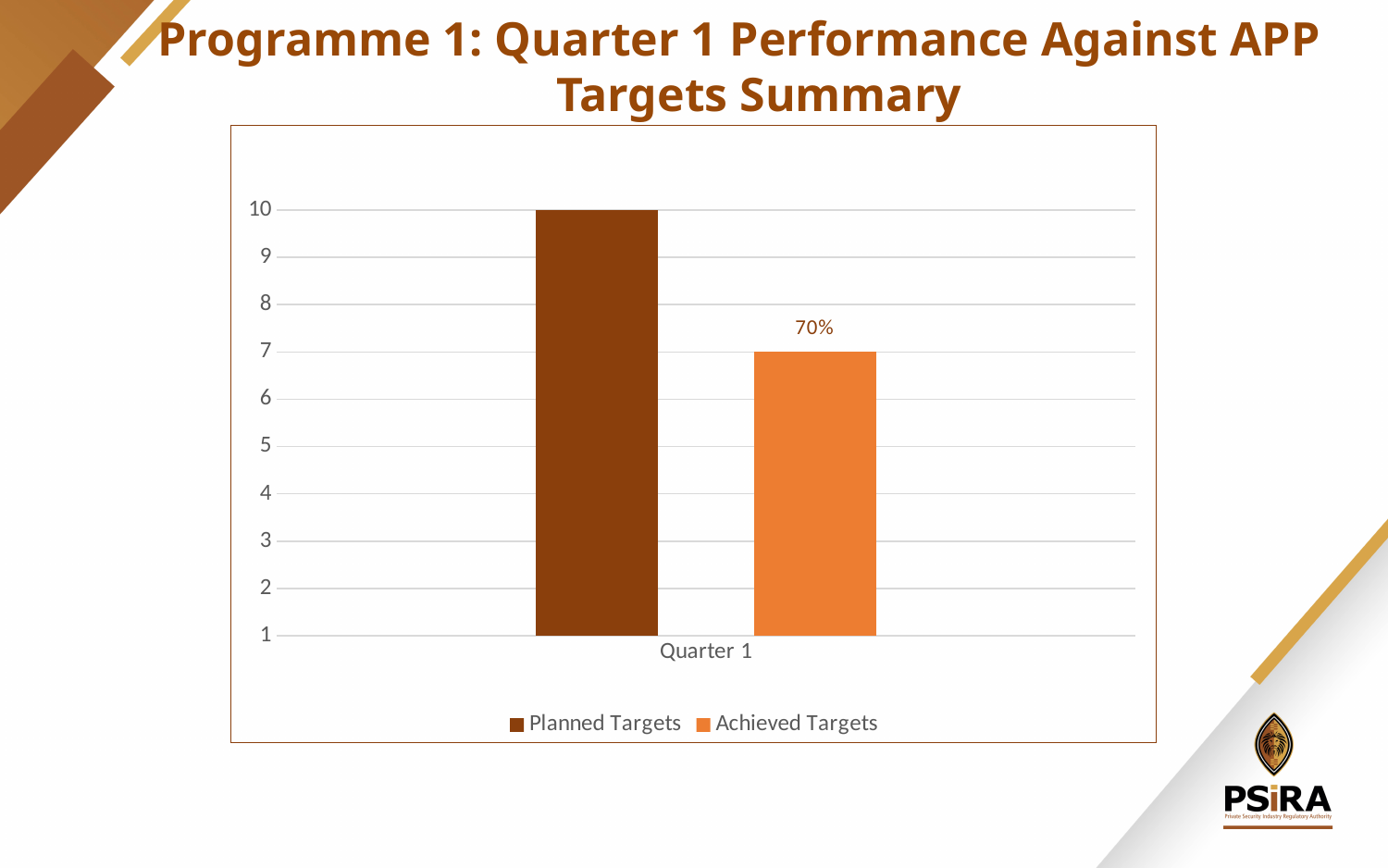
What value does the Planned Targets bar reach for Quarter 1? 10 What is the difference between the Planned Targets bar and the Achieved Targets bar for Quarter 1? 3 How many categories are shown on the x axis? 1 Is the value for Achieved Targets greater or less than 8? less Which series has the lowest bar for Quarter 1? Achieved Targets What is the category label on the x axis? Quarter 1 What value does the Achieved Targets bar reach on the axis for Quarter 1? 7 Which series has the higher bar for Quarter 1, Planned Targets or Achieved Targets? Planned Targets What are the two series named in the legend? Planned Targets and Achieved Targets What data label is printed above the Achieved Targets bar? 70% What kind of chart is shown on the slide? Bar chart How many series does the legend list? 2